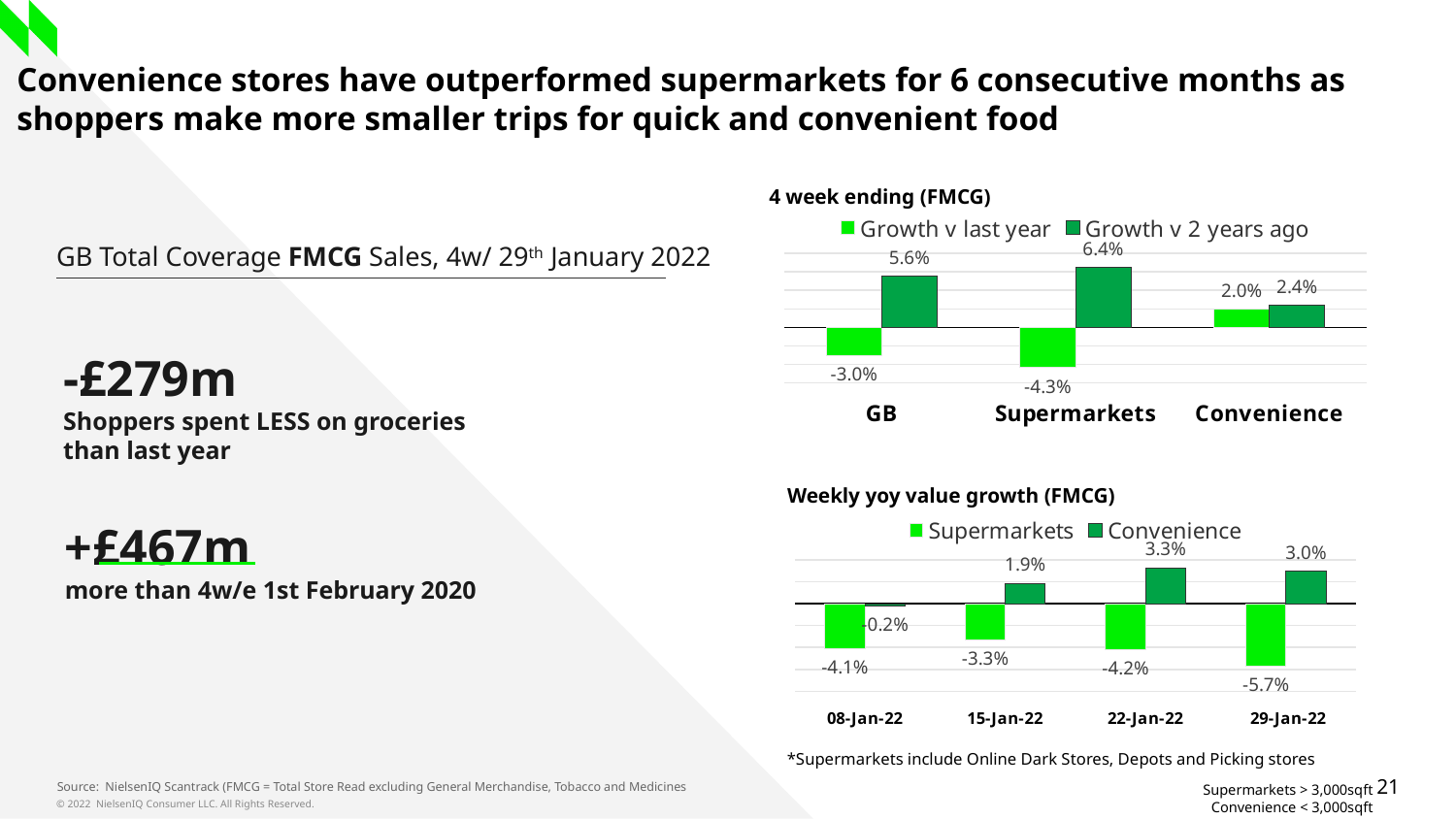
In the '4 week ending (FMCG)' chart, what is the Growth v 2 years ago value for GB? 5.6% In the '4 week ending (FMCG)' chart, which category has the highest Growth v 2 years ago? Supermarkets In the 'Weekly yoy value growth (FMCG)' chart, which week has the lowest Supermarkets value? 29-Jan-22 In the '4 week ending (FMCG)' chart, what is the Growth v last year value for Supermarkets? -4.3% In the 'Weekly yoy value growth (FMCG)' chart, how many weeks are shown on the x axis? 4 How many series does the legend of the '4 week ending (FMCG)' chart list? 2 In the 'Weekly yoy value growth (FMCG)' chart, is the Supermarkets value or the Convenience value larger for 15-Jan-22? Convenience In the '4 week ending (FMCG)' chart, which category has the lowest Growth v last year? Supermarkets What kind of chart is the 'Weekly yoy value growth (FMCG)' chart? Bar chart In the 'Weekly yoy value growth (FMCG)' chart, what is the Supermarkets value for 29-Jan-22? -5.7% In the '4 week ending (FMCG)' chart, what is the difference between the Growth v 2 years ago and Growth v last year values for Convenience? 0.4% In the 'Weekly yoy value growth (FMCG)' chart, what is the Convenience value for 22-Jan-22? 3.3%